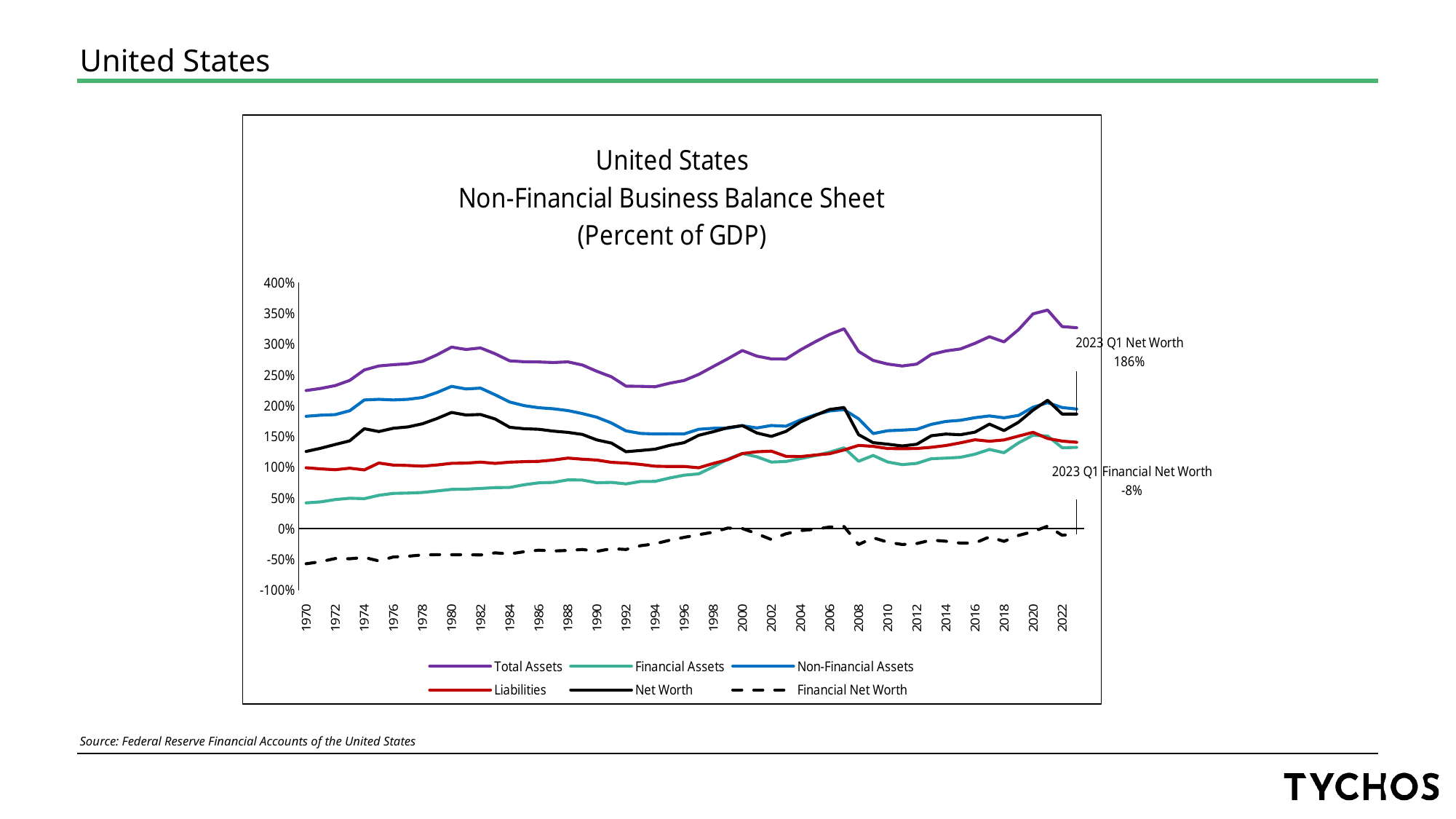
In 1970, which is larger: Non-Financial Assets or Financial Assets? Non-Financial Assets Is the value for Financial Assets in 1970 greater or less than 100%? less Which series has the highest values across the whole period? Total Assets How many series does the legend list? 6 Which series is drawn with a dashed line? Financial Net Worth What is the 2023 Q1 value of Financial Net Worth shown on the chart? -8% What kind of chart is shown on the slide? line chart What is the 2023 Q1 value of Net Worth shown on the chart? 186% What is the difference between the 2023 Q1 Net Worth and the 2023 Q1 Financial Net Worth values printed on the chart? 194% Do Financial Assets rise or fall from 1970 to 2022? rise Is the value for Total Assets in 2020 greater or less than 300%? greater Which series has the lowest values across the whole period? Financial Net Worth